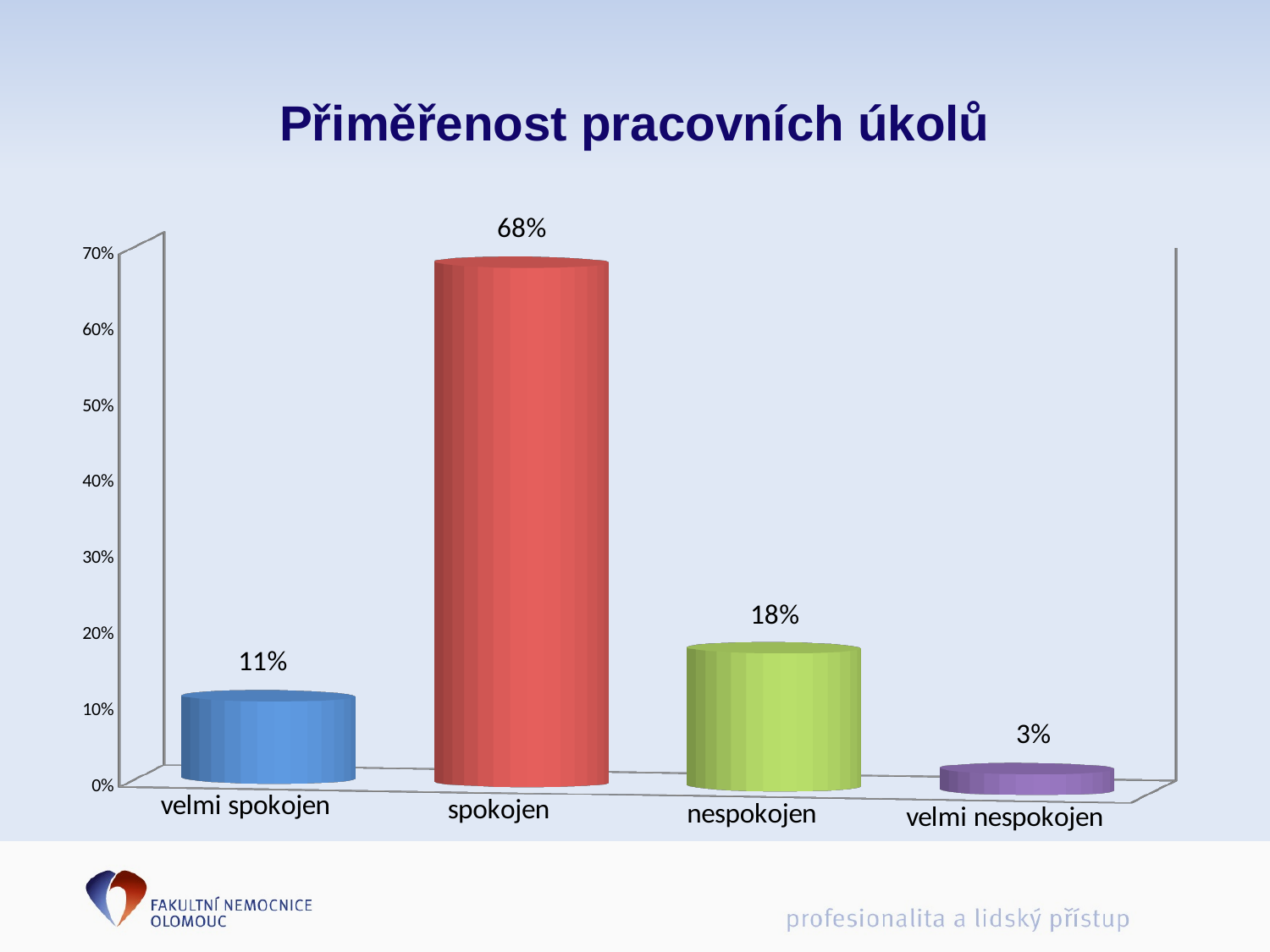
How many categories are shown on the chart? 4 Which category has the lowest value? velmi nespokojen Which is larger, the value for "velmi spokojen" or the value for "nespokojen"? nespokojen Which category has the highest value? spokojen What is the value for "nespokojen"? 18% What is the value for "velmi spokojen"? 11% What is the value for "spokojen"? 68% What kind of chart is shown on the slide? bar chart What is the value for "velmi nespokojen"? 3% What is the difference between the values for "nespokojen" and "velmi spokojen"? 7% What is the difference between the values for "spokojen" and "nespokojen"? 50% What is the title of the chart? Přiměřenost pracovních úkolů